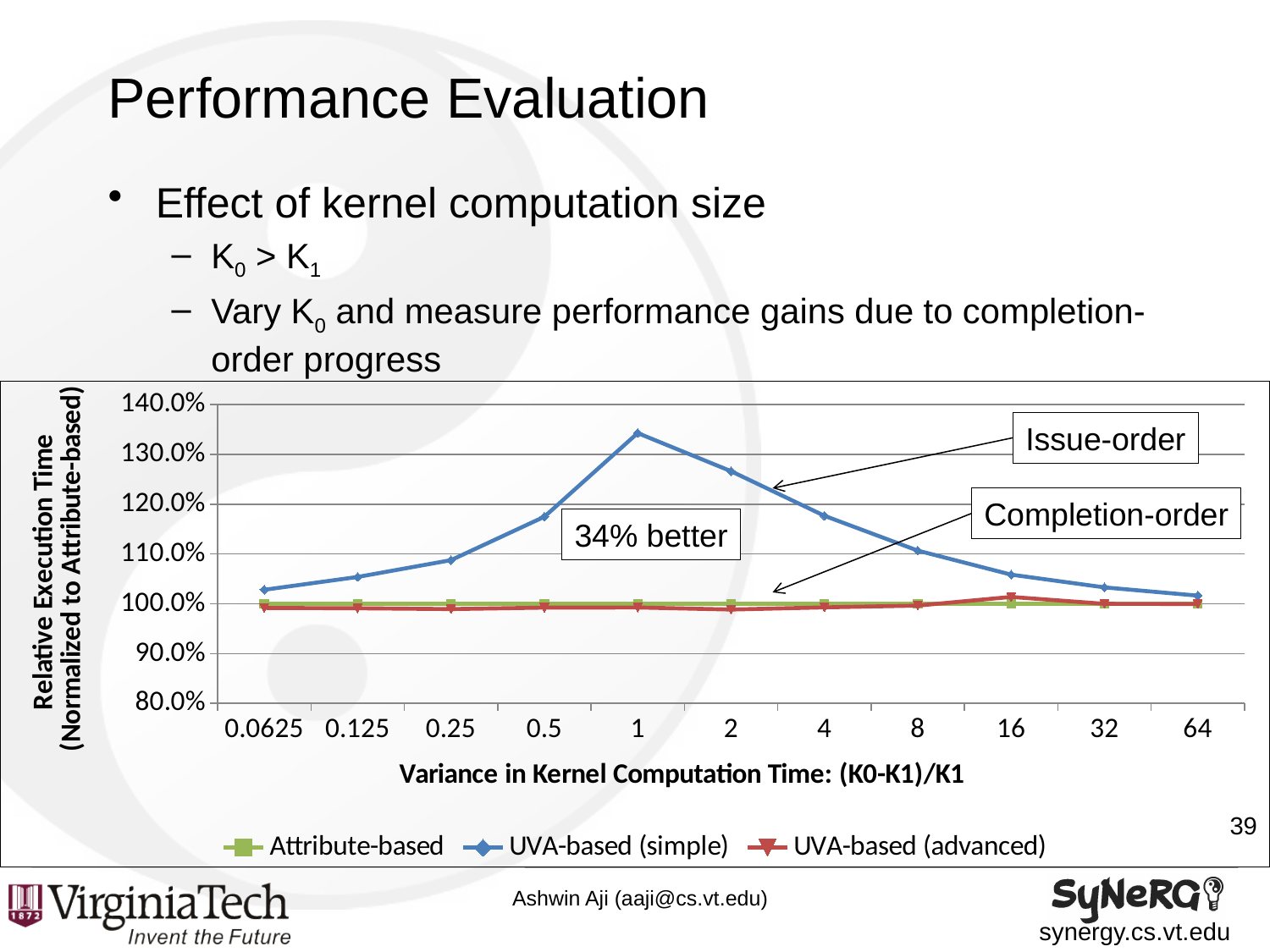
Is the value of UVA-based (simple) at x = 1 greater or less than 130.0%? greater What kind of chart is shown on the slide? line chart What is the x-axis title of the chart? Variance in Kernel Computation Time: (K0-K1)/K1 How many x-axis categories are plotted on the chart? 11 What percentage improvement does the annotation near the peak of the chart state? 34% better How many series does the chart legend list? 3 Which series has the larger value at x = 1, UVA-based (simple) or Attribute-based? UVA-based (simple) Is the value of UVA-based (simple) at x = 0.0625 greater or less than 100.0%? greater Does the UVA-based (simple) series rise or fall as x increases from 0.0625 to 1? rise Is the value of UVA-based (simple) at x = 64 greater or less than 110.0%? less At which x-axis value does the UVA-based (simple) series reach its highest point? 1 Does the UVA-based (simple) series rise or fall as x increases from 1 to 64? fall